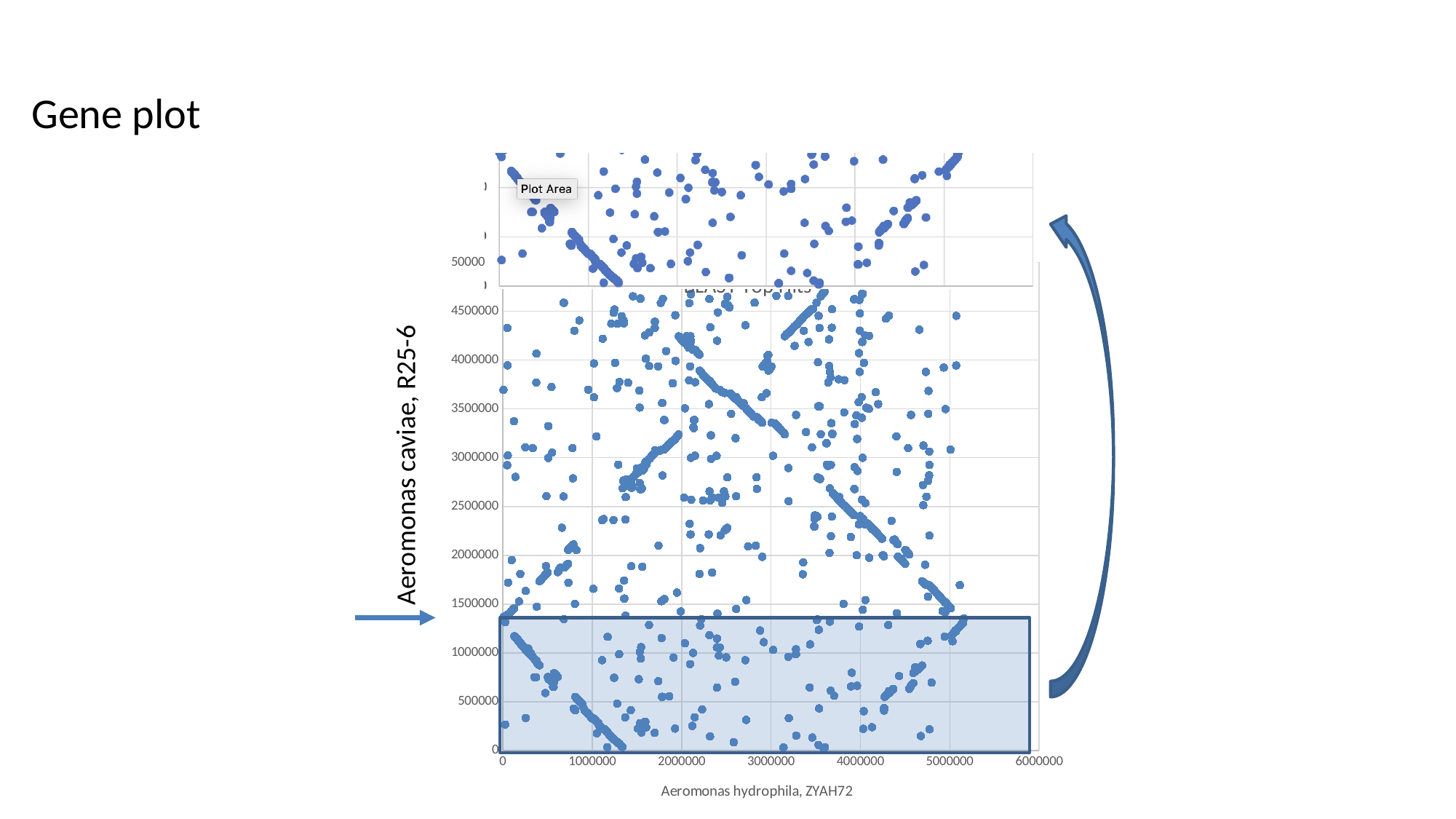
What is the interval between consecutive labelled ticks on the y axis of the main chart? 500000 What is the highest tick value shown on the x axis of the chart? 6000000 What is the interval between consecutive labelled ticks on the x axis of the chart? 1000000 What is the lowest tick value shown on the x axis of the chart? 0 What is the label of the y axis of the chart? Aeromonas caviae, R25-6 What is the highest tick value labelled on the y axis of the main chart? 4500000 What is the label of the x axis of the chart? Aeromonas hydrophila, ZYAH72 What kind of chart is shown on the slide? scatter chart